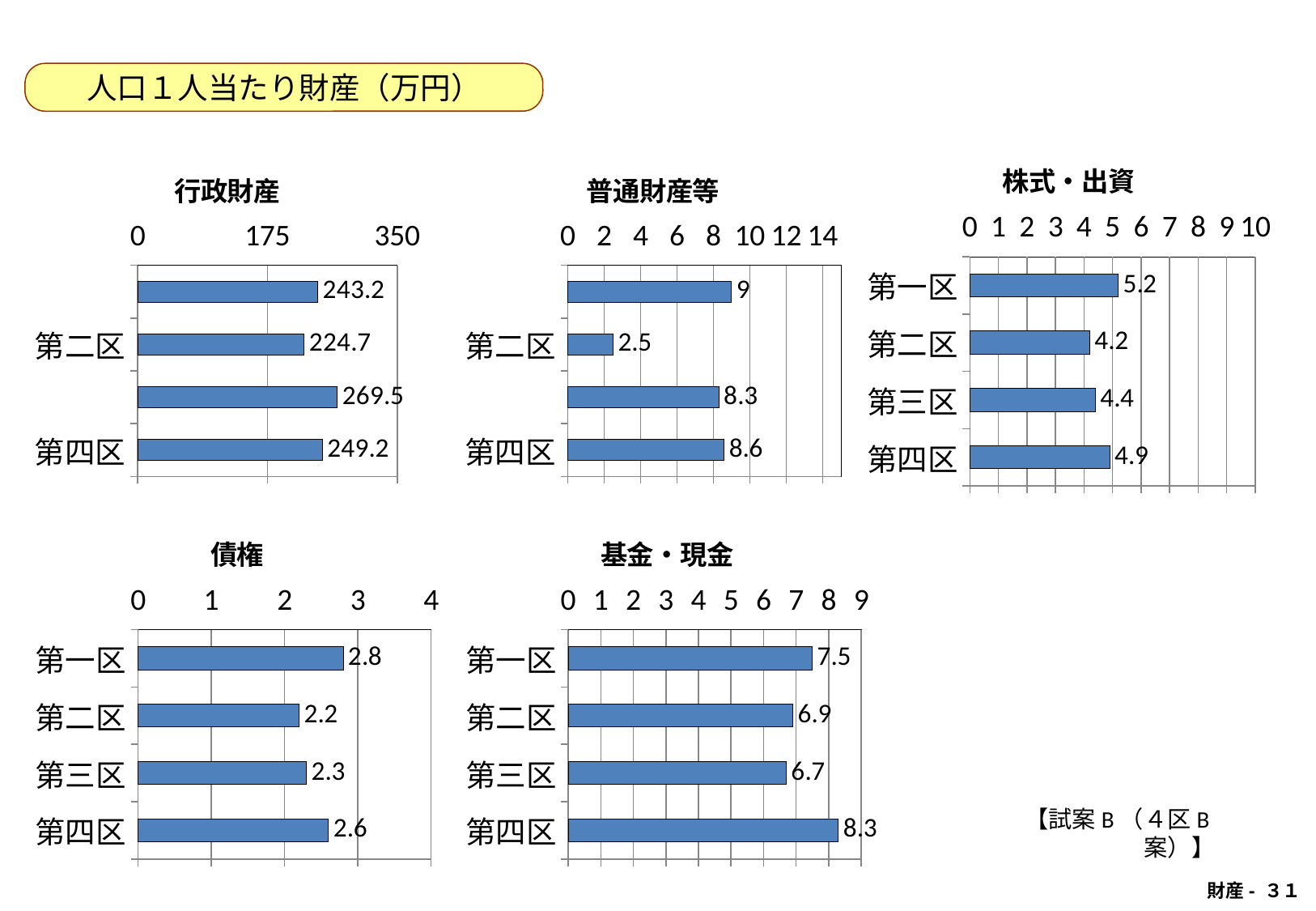
In the 普通財産等 chart, what is the difference between the values for 第四区 and 第二区? 6.1 In the 基金・現金 chart, which district has the lowest value? 第三区 In the 基金・現金 chart, is the value for 第二区 larger or smaller than the value for 第四区? smaller How many charts are shown on the slide? 5 In the 債権 chart, what is the value for 第三区? 2.3 In the 行政財産 chart, what is the value for 第二区? 224.7 In the 基金・現金 chart, what is the difference between the values for 第四区 and 第一区? 0.8 In the 株式・出資 chart, which district has the lowest value? 第二区 In the 行政財産 chart, what is the value for 第四区? 249.2 In the 普通財産等 chart, what is the value for 第二区? 2.5 In the 債権 chart, which district has the highest value? 第一区 In the 株式・出資 chart, which district has the highest value? 第一区